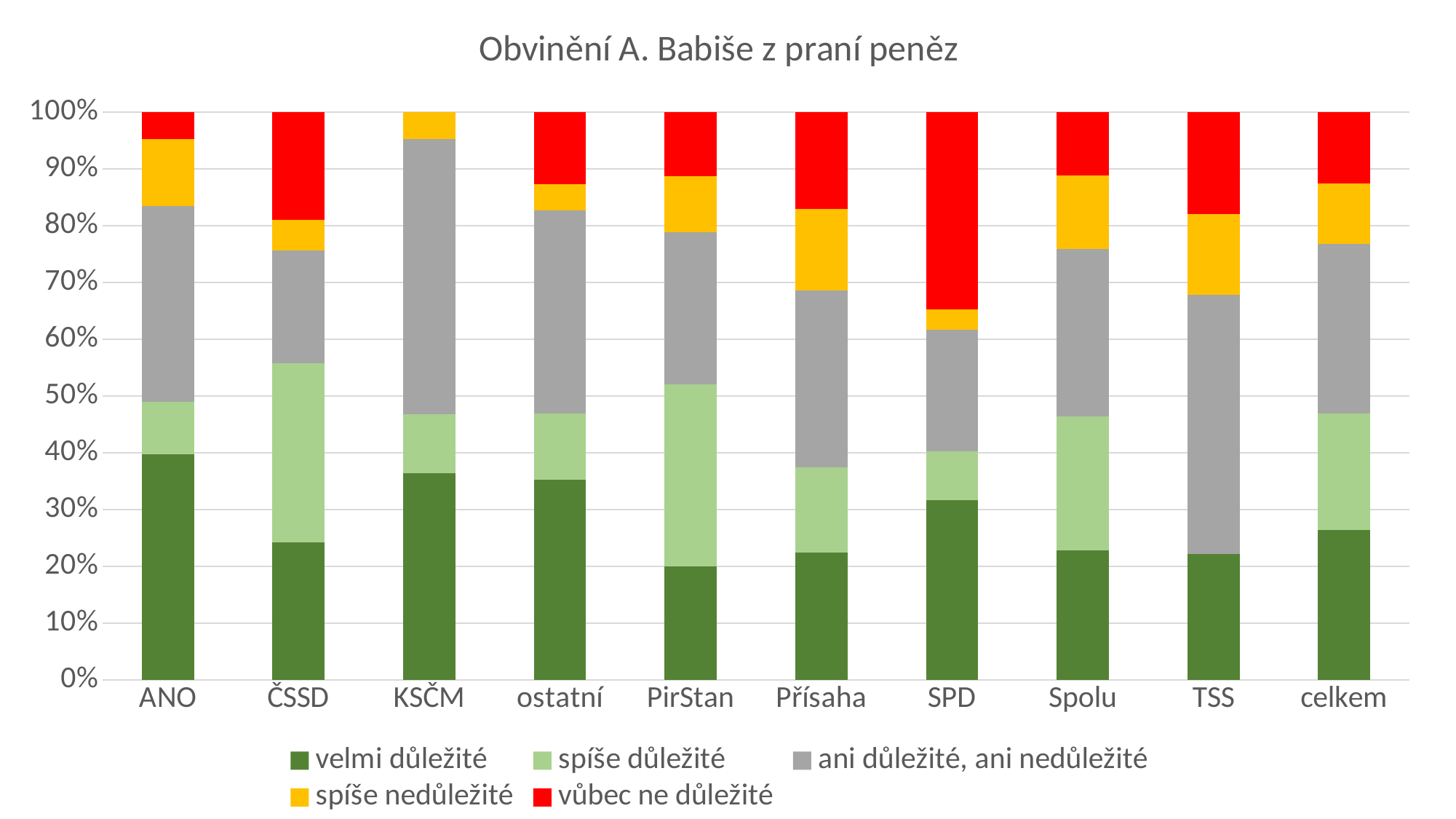
Which colour represents the series 'vůbec ne důležité' in the legend? red Which category has the lowest share of 'vůbec ne důležité'? KSČM What kind of chart is shown on the slide? stacked bar chart Is the 'velmi důležité' share for PirStan greater or less than 30%? less Which is larger: the 'velmi důležité' share for ANO or for ČSSD? ANO Is the 'velmi důležité' share for ANO greater or less than 30%? greater How many categories are shown along the x axis? 10 What is the title of the chart? Obvinění A. Babiše z praní peněz What is the total of the stacked bar for celkem? 100% Which category has the highest share of 'vůbec ne důležité'? SPD How many series does the legend list? 5 Which category has the highest share of 'velmi důležité'? ANO